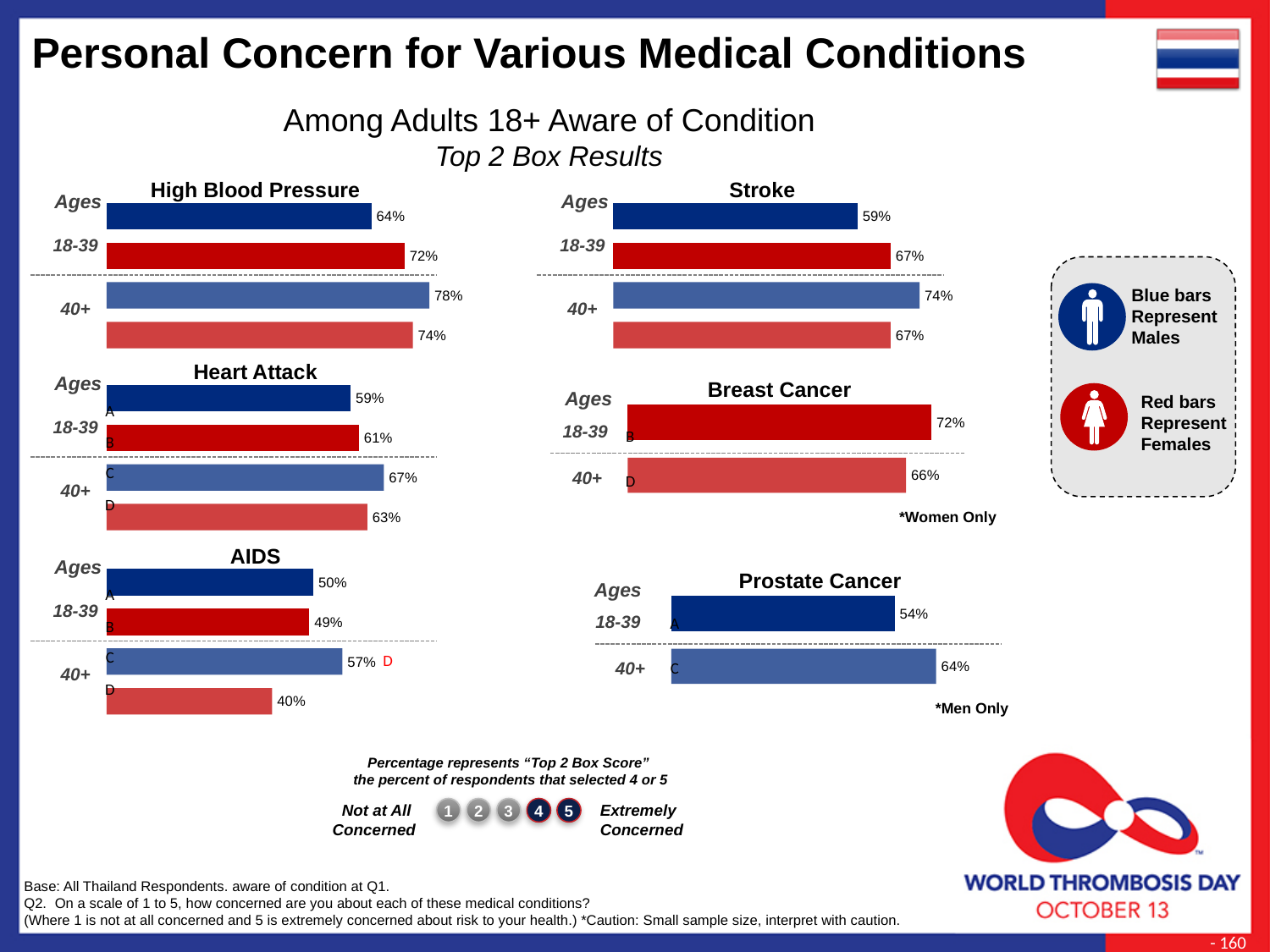
In the AIDS chart, what is the difference between males aged 40+ and females aged 40+? 17 percentage points In the AIDS chart, which bar has the lowest value? Females aged 40+ (40%) How many bars does the Breast Cancer chart show? 2 What type of chart is used for the Heart Attack data? Bar chart In the Stroke chart, which is larger: males aged 40+ or females aged 40+? Males aged 40+ In the High Blood Pressure chart, which bar has the highest value? Males aged 40+ (78%) In the High Blood Pressure chart, what is the value for males aged 40+? 78% In the Breast Cancer chart, what is the value for ages 18-39? 72% In the Prostate Cancer chart, what is the difference between ages 40+ and ages 18-39? 10 percentage points In the Prostate Cancer chart, what is the value for ages 40+? 64% In the Stroke chart, what is the value for females aged 18-39? 67% In the Heart Attack chart, what is the value for females aged 40+? 63%